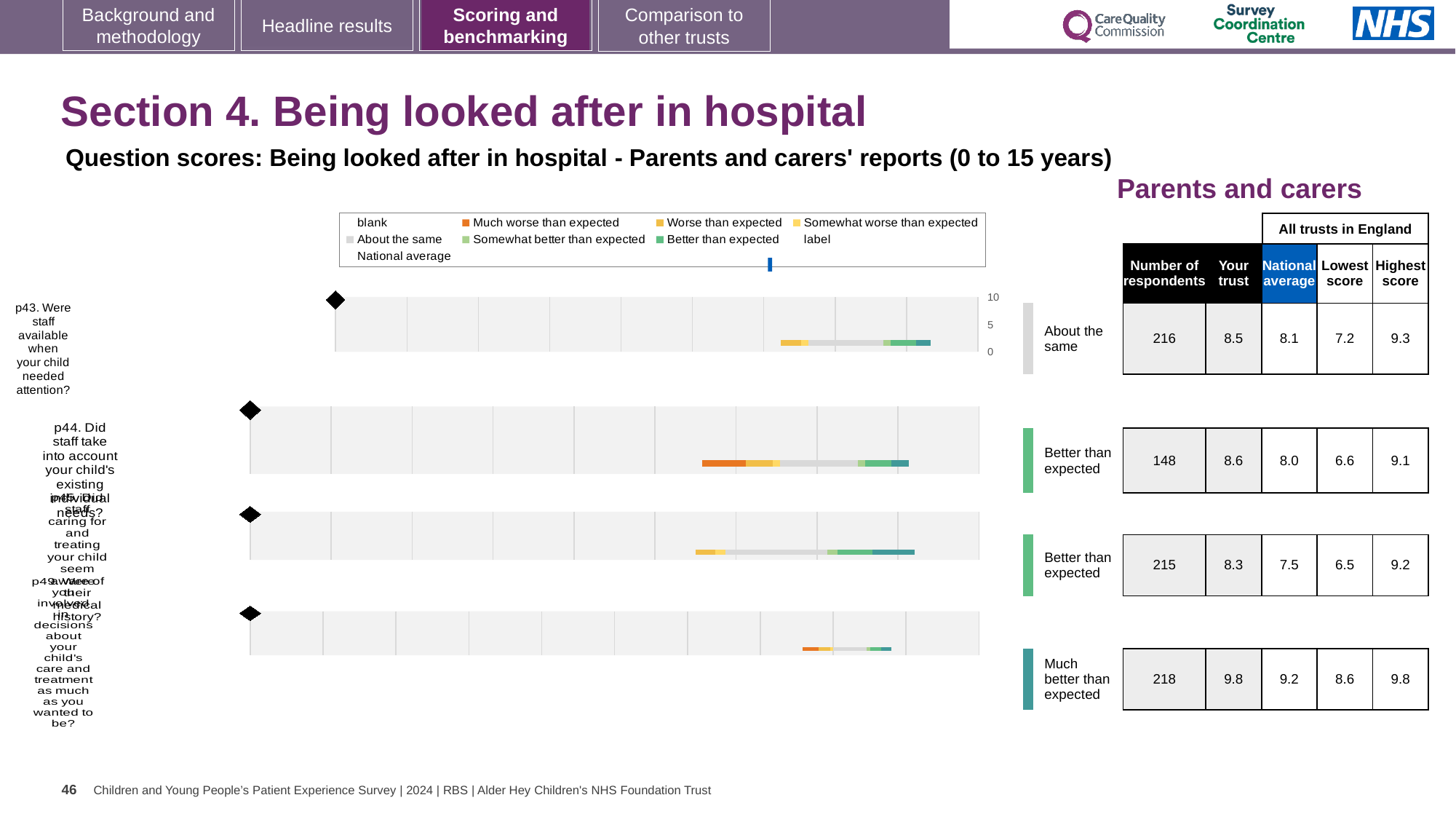
Which question has the lowest number of respondents? p44 Which question has the highest 'Your trust' score? p49 What is the highest score across all trusts in England for p43? 9.3 How many respondents answered p44 (Did staff take into account your child's existing individual needs?)? 148 How many questions (rows) are plotted in the chart? 4 What benchmark category is shown for p49? Much better than expected What is the national average for p49 (Were you involved in decisions about your child's care and treatment as much as you wanted to be?)? 9.2 Is the 'Your trust' score for p44 higher or lower than the national average for p44? higher What kind of chart is used to show the question scores on this slide? bar chart What is the 'Your trust' score for p43 (Were staff available when your child needed attention?)? 8.5 What is the lowest score across all trusts in England for p45 (Did staff caring for and treating your child seem aware of their medical history?)? 6.5 What is the difference between the 'Your trust' score and the national average for p45? 0.8